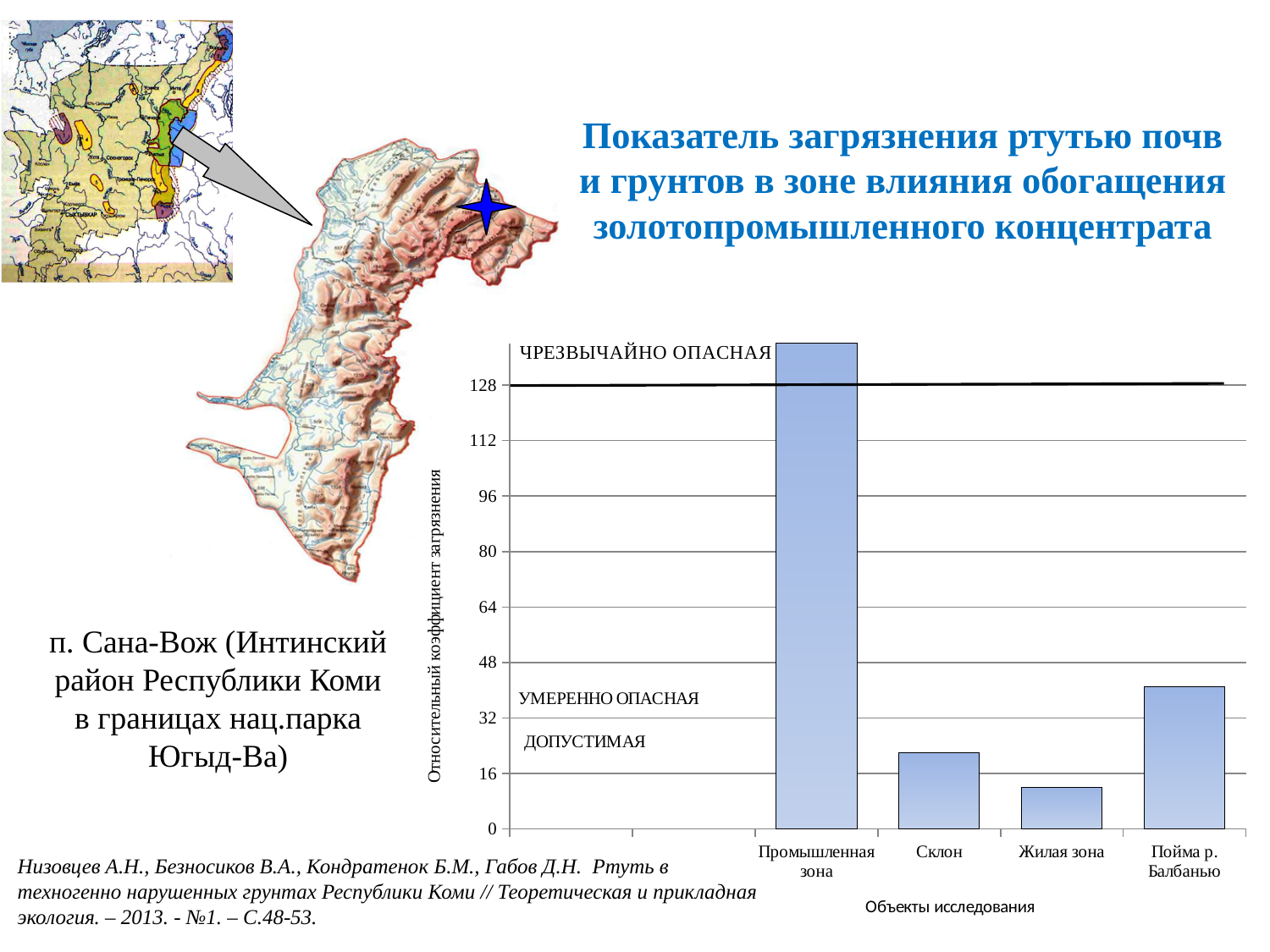
Is the value for Промышленная зона greater or less than 128? greater How many categories are shown on the x axis of the chart? 4 Which is larger, the value for Склон or the value for Жилая зона? Склон Which is larger, the value for Склон or the value for Пойма р. Балбанью? Пойма р. Балбанью What is the label of the vertical axis of the chart? Относительный коэффициент загрязнения What is the label of the horizontal axis of the chart? Объекты исследования Which category has the lowest value in the chart? Жилая зона Is the value for Жилая зона greater or less than 16? less Is the value for Пойма р. Балбанью greater or less than 32? greater What kind of chart is shown on the slide? bar chart Which category has the highest value in the chart? Промышленная зона